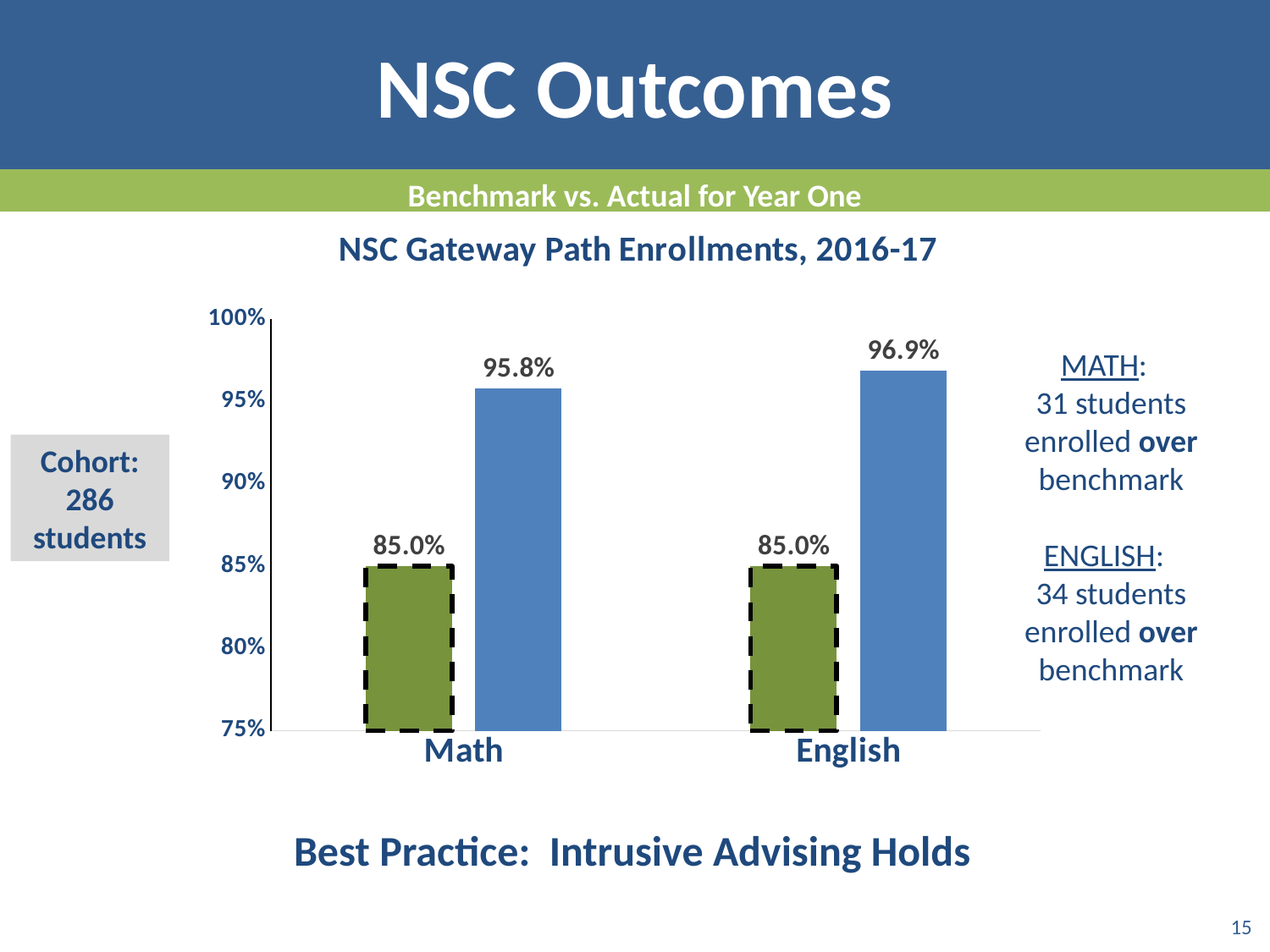
What kind of chart is shown on the slide? Bar chart What is the title of the chart? NSC Gateway Path Enrollments, 2016-17 What is the value of the green dashed bar for Math? 85.0% What is the difference between the blue bar and the green bar for Math? 10.8 percentage points What is the difference between the blue bars for English and Math? 1.1 percentage points What is the value of the blue bar for Math? 95.8% How many categories are shown on the x axis? 2 Is the blue bar for Math greater or less than 95%? greater Which category has the higher blue bar, Math or English? English What is the value of the blue bar for English? 96.9% What is the difference between the blue bar and the green bar for English? 11.9 percentage points What is the value of the green dashed bar for English? 85.0%